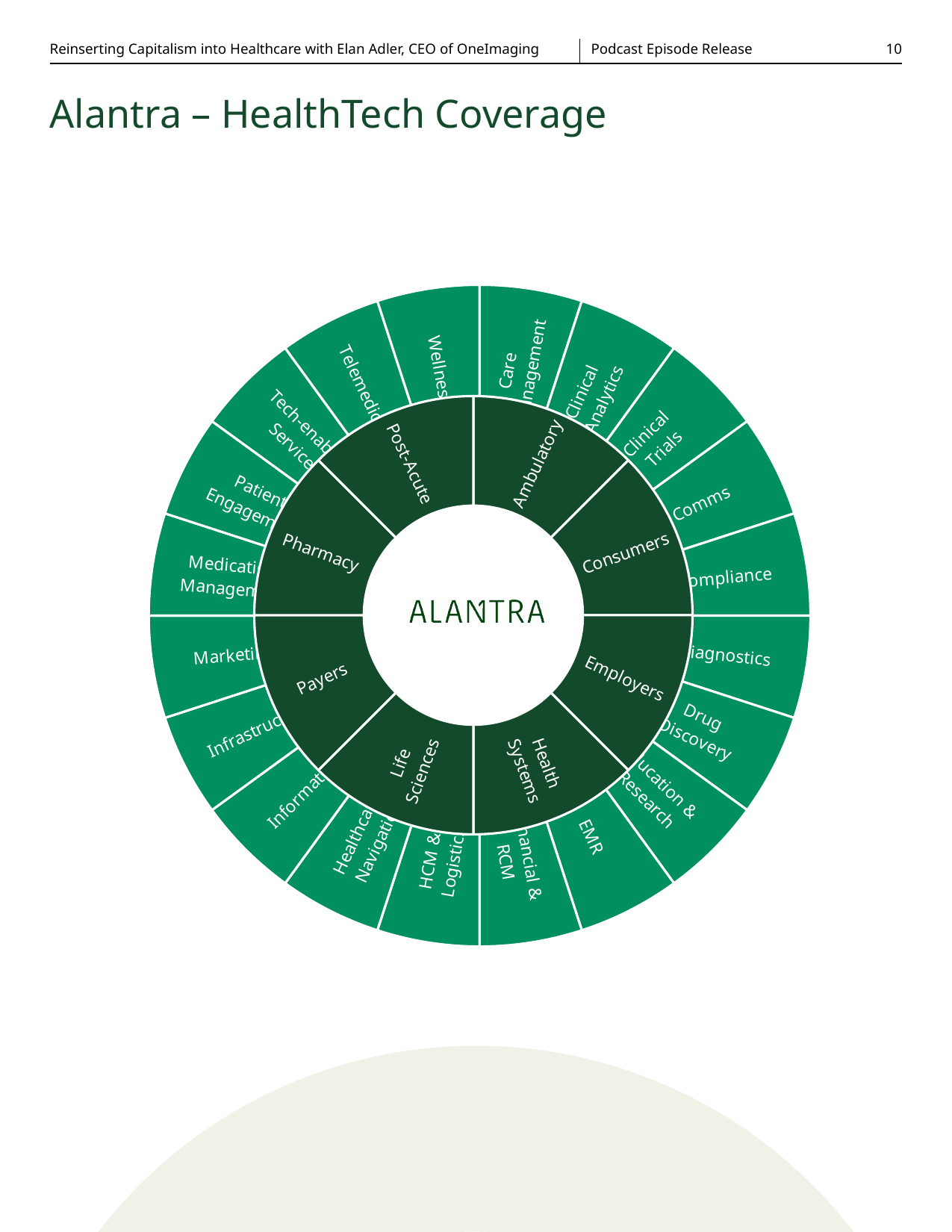
How many segments are in the inner ring of the chart? 8 Which inner-ring segment sits directly opposite Payers in the chart? Consumers Which inner-ring segment lies between Ambulatory and Employers in the chart? Consumers How many segments are in the outer ring of the chart? 20 Which outer-ring segment is adjacent to EMR on the clockwise side in the chart? Financial & RCM What kind of chart is shown on the slide? Doughnut (sunburst) chart What text appears in the centre of the chart? ALANTRA Which inner-ring segment lies between Payers and Post-Acute in the chart? Pharmacy What is the title of the slide containing the chart? Alantra – HealthTech Coverage How many rings does the chart have? 2